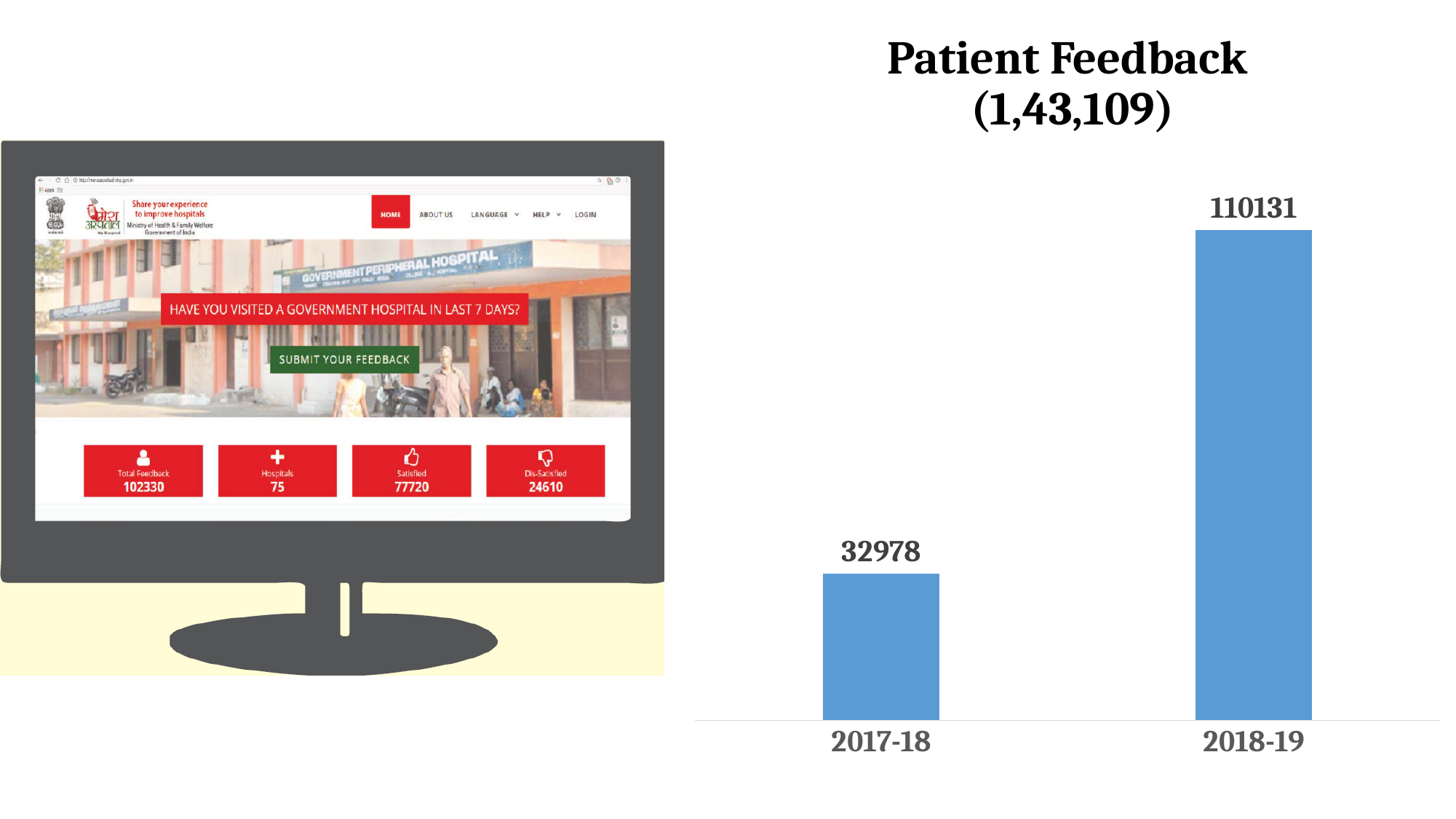
Do the values in the Patient Feedback chart rise or fall from 2017-18 to 2018-19? Rise Which is larger in the Patient Feedback chart, the value for 2017-18 or 2018-19? 2018-19 What colour are the bars in the Patient Feedback chart? Blue How many categories are shown on the x axis of the Patient Feedback chart? 2 Which year has the highest patient feedback value? 2018-19 What is the value for 2017-18 in the Patient Feedback chart? 32978 What is the total of the two values shown in the Patient Feedback chart? 143109 What is the value for 2018-19 in the Patient Feedback chart? 110131 What kind of chart is the Patient Feedback chart? Bar chart Which year has the lowest patient feedback value? 2017-18 What is the title of the chart on the slide? Patient Feedback (1,43,109) What is the difference between the 2018-19 and 2017-18 values in the Patient Feedback chart? 77153